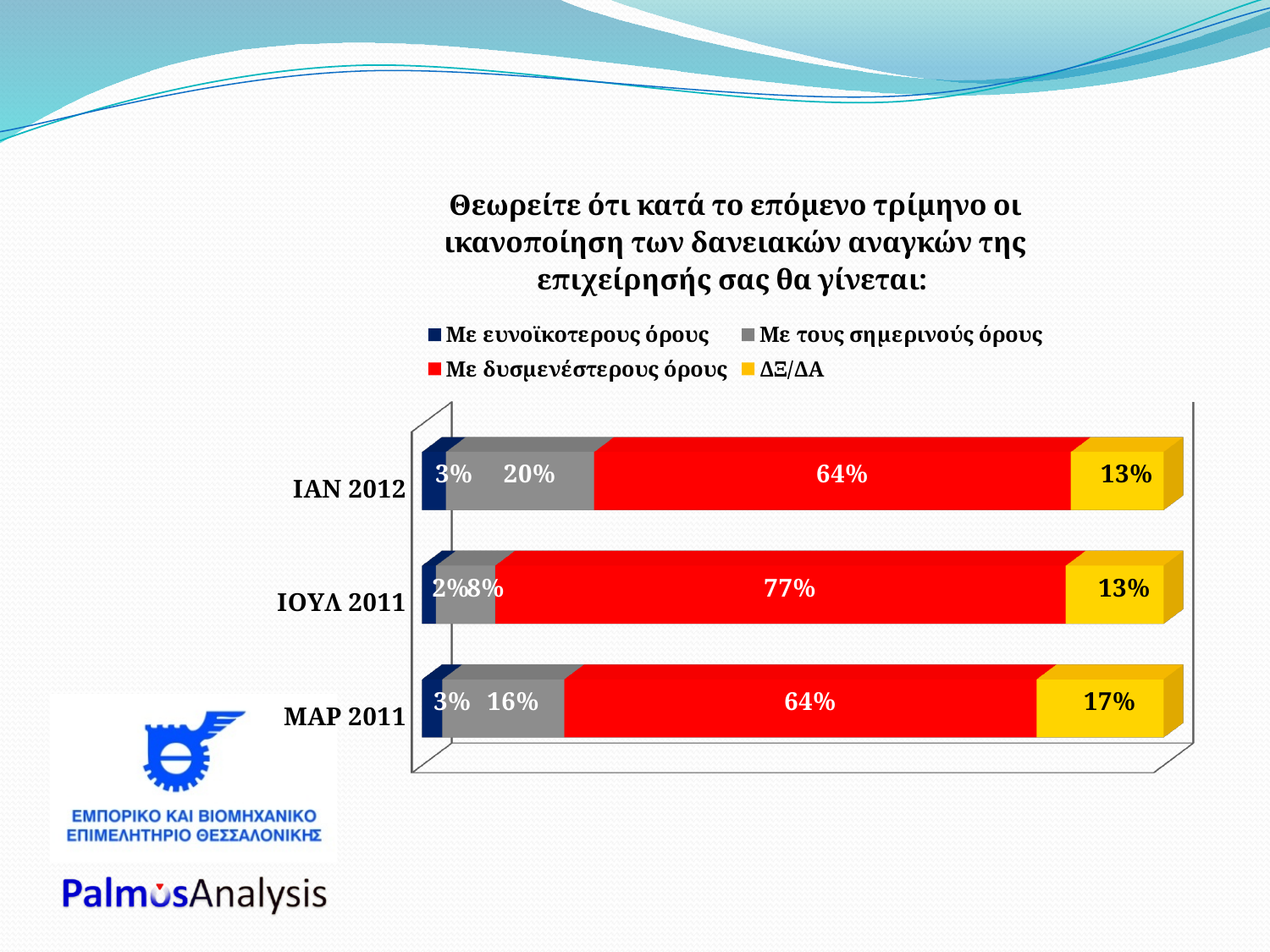
What type of chart is shown on the slide? Stacked bar chart Which is larger: the 'ΔΞ/ΔΑ' value for ΜΑΡ 2011 or for ΙΑΝ 2012? ΜΑΡ 2011 What is the value for 'Με ευνοϊκοτερους όρους' in ΙΟΥΛ 2011? 2% What is the difference between the 'Με δυσμενέστερους όρους' values for ΙΟΥΛ 2011 and ΙΑΝ 2012? 13% In which period is the value for 'Με δυσμενέστερους όρους' highest? ΙΟΥΛ 2011 What is the value for 'Με τους σημερινούς όρους' in ΙΑΝ 2012? 20% Which colour represents 'ΔΞ/ΔΑ' in the chart? Yellow In which period is the value for 'Με τους σημερινούς όρους' lowest? ΙΟΥΛ 2011 How many categories (time periods) are shown on the chart? 3 What is the value for 'Με δυσμενέστερους όρους' in ΙΟΥΛ 2011? 77% What is the value for 'ΔΞ/ΔΑ' in ΜΑΡ 2011? 17% How many series does the legend list? 4